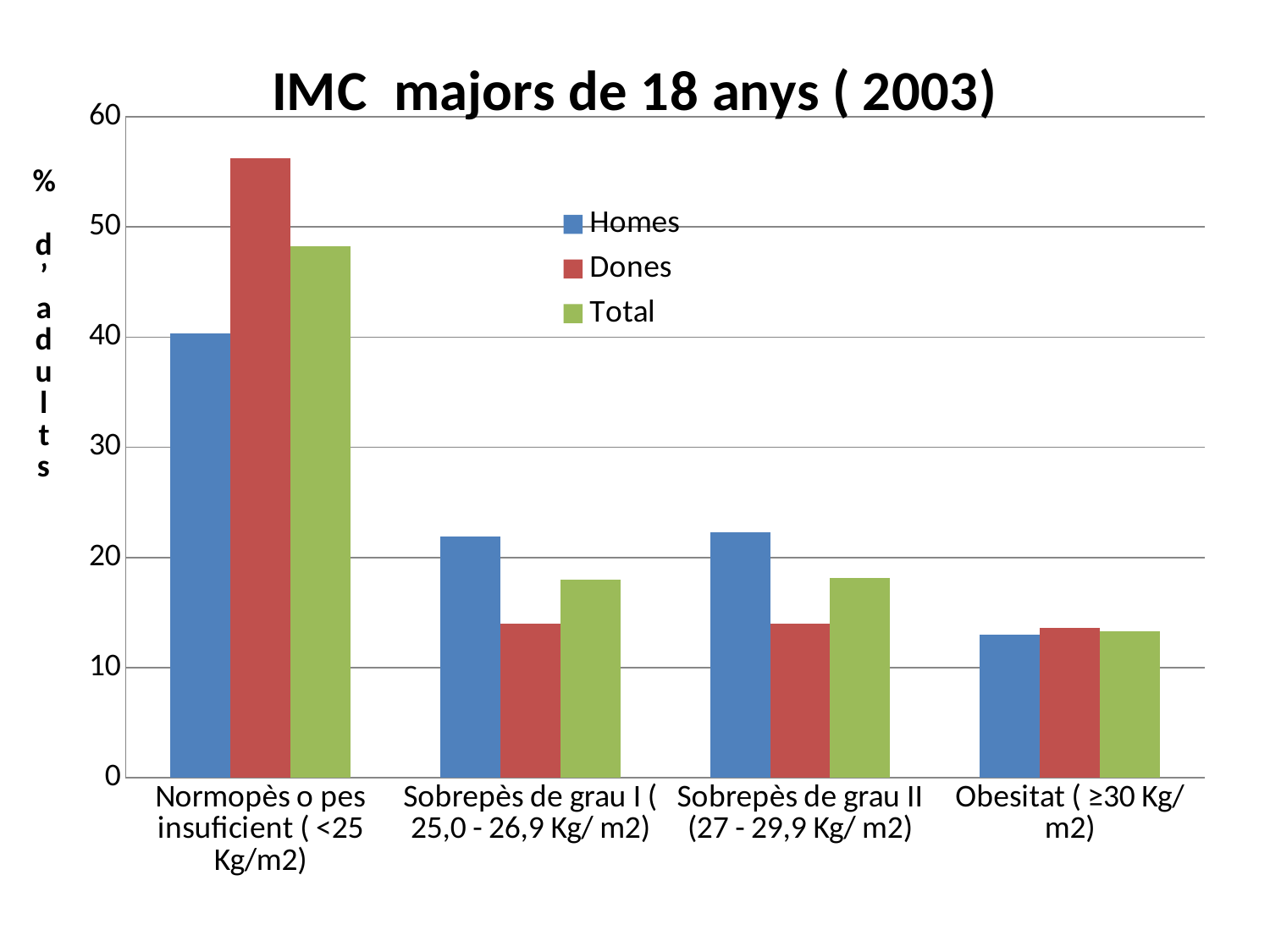
Is the value for Total in the Normopès o pes insuficient category greater or less than 50? less In the Normopès o pes insuficient category, which is larger, Homes or Dones? Dones How many series does the legend list? 3 Which colour represents the Total series in the legend? green How many categories are shown on the x axis? 4 Is the value for Dones in the Normopès o pes insuficient category greater or less than 50? greater Is the value for Dones in the Sobrepès de grau II category greater or less than 20? less In the Sobrepès de grau I category, which is larger, Homes or Dones? Homes Which category has the highest value for Dones? Normopès o pes insuficient ( <25 Kg/m2) What kind of chart is shown on the slide? bar chart What is the title of the chart? IMC majors de 18 anys ( 2003) Which category has the lowest value for Homes? Obesitat ( ≥30 Kg/ m2)